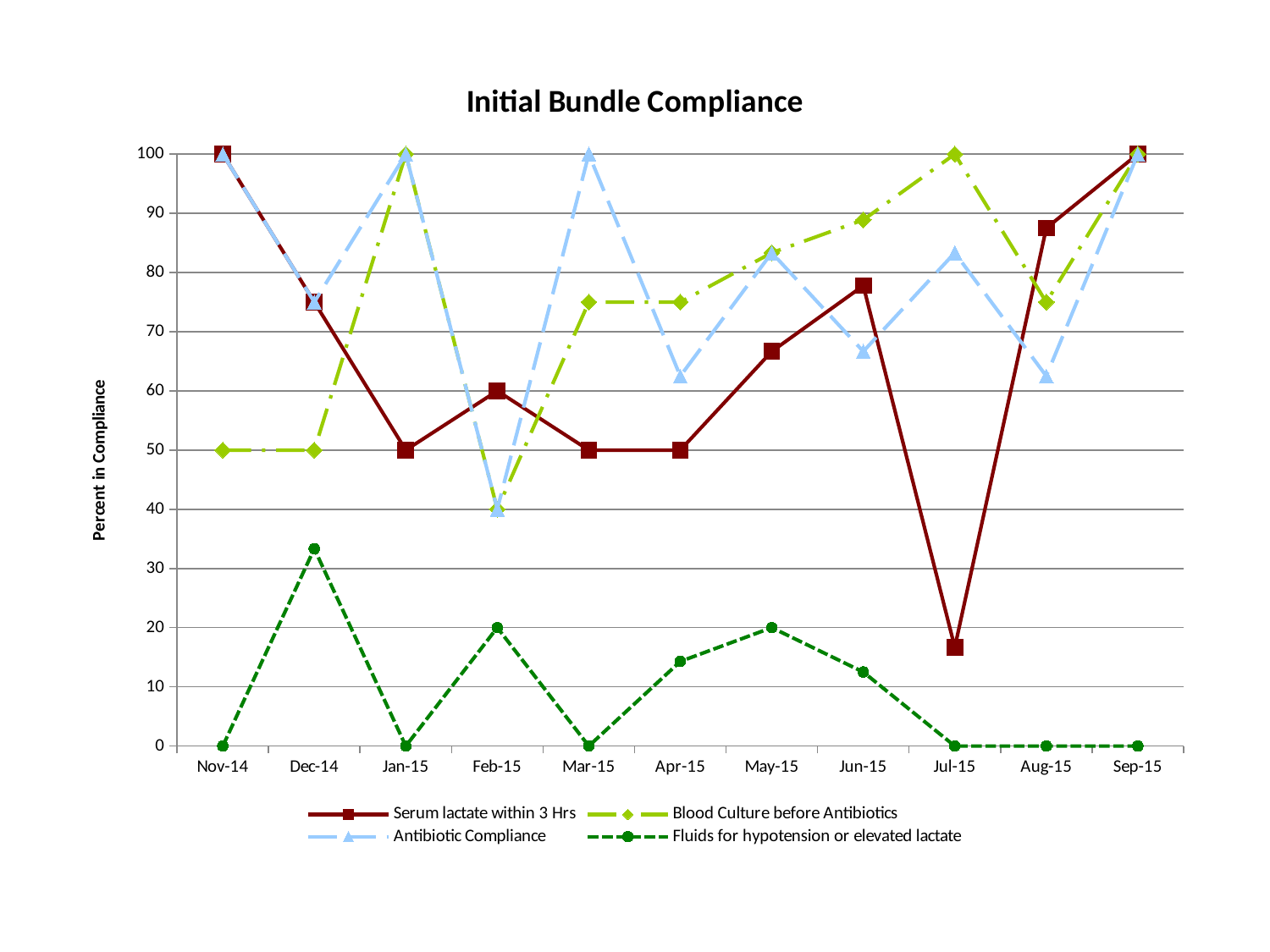
In which month is Serum lactate within 3 Hrs at its lowest? Jul-15 What type of chart is shown on the slide? Line chart What is the value for Blood Culture before Antibiotics in Nov-14? 50 What is the value for Antibiotic Compliance in Feb-15? 40 What is the value for Fluids for hypotension or elevated lactate in May-15? 20 Is the value for Serum lactate within 3 Hrs in Jul-15 greater or less than 20? less Is the value for Fluids for hypotension or elevated lactate in Dec-14 greater or less than 30? greater How many series does the legend list? 4 What is the title of the chart? Initial Bundle Compliance What is the value for Serum lactate within 3 Hrs in Feb-15? 60 What is the difference between Serum lactate within 3 Hrs in Nov-14 and in Jan-15? 50 How many months are shown on the x axis? 11